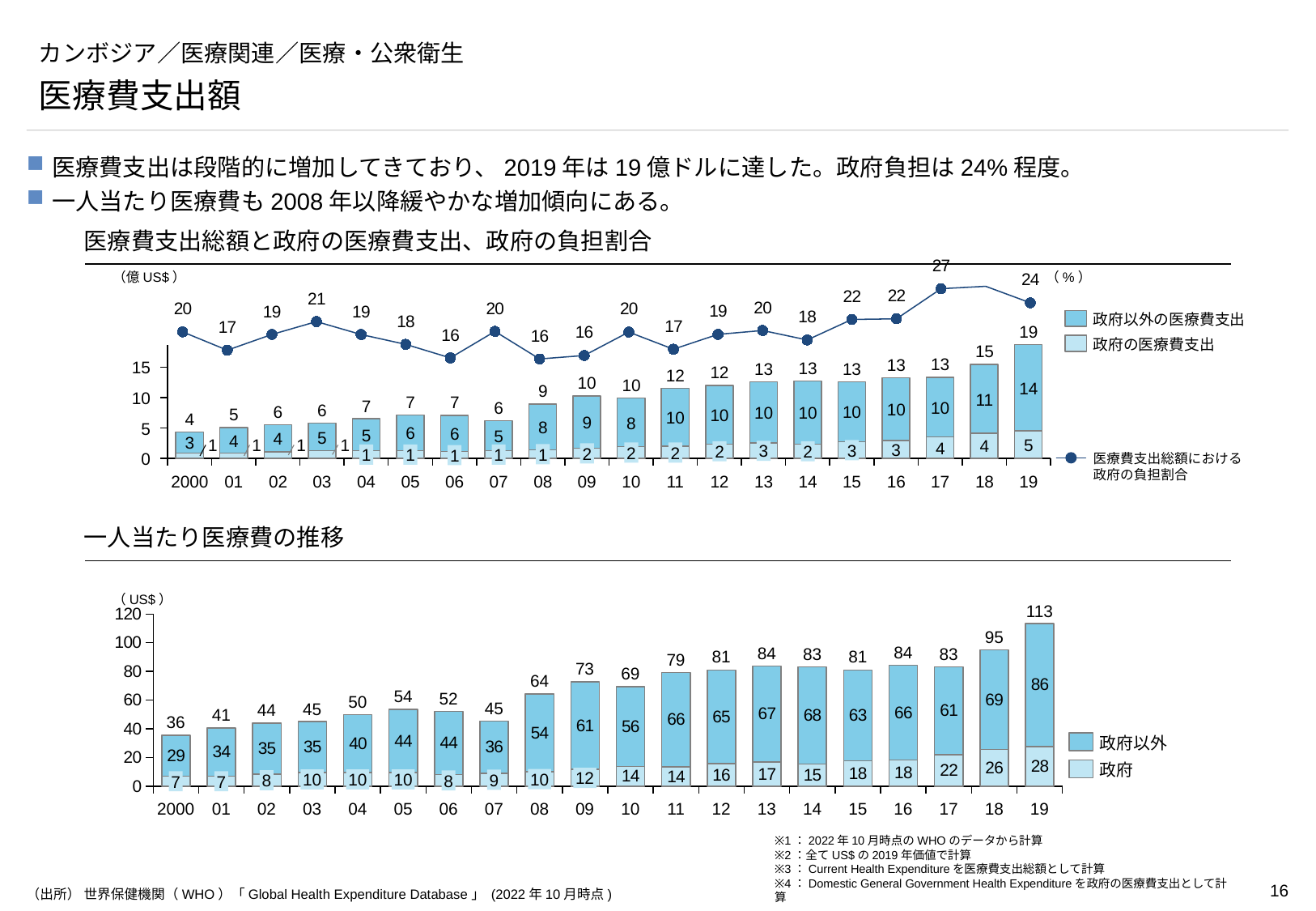
In the top chart (医療費支出総額と政府の医療費支出、政府の負担割合), what is the total health expenditure for 2019 in 億 US$? 19 In the bottom chart, how many years are shown on the x axis? 20 In the bottom chart, what is the difference between the per-capita total for 2019 and 2018? 18 In the bottom chart, is the per-capita total for 2009 larger than that for 2010? Yes What kind of chart is the bottom chart (一人当たり医療費の推移)? Stacked bar chart In the top chart, which year has the highest total health expenditure? 19 In the top chart, what is the value of 政府の医療費支出 for 2019? 5 In the bottom chart, what is the 政府 value for 2018? 26 In the bottom chart, which year has the lowest per-capita health expenditure? 2000 In the top chart, how many series does the legend list? 3 In the bottom chart (一人当たり医療費の推移), what is the per-capita health expenditure for 2019 in US$? 113 In the top chart, what is the government share (%) of total health expenditure in 2017? 27